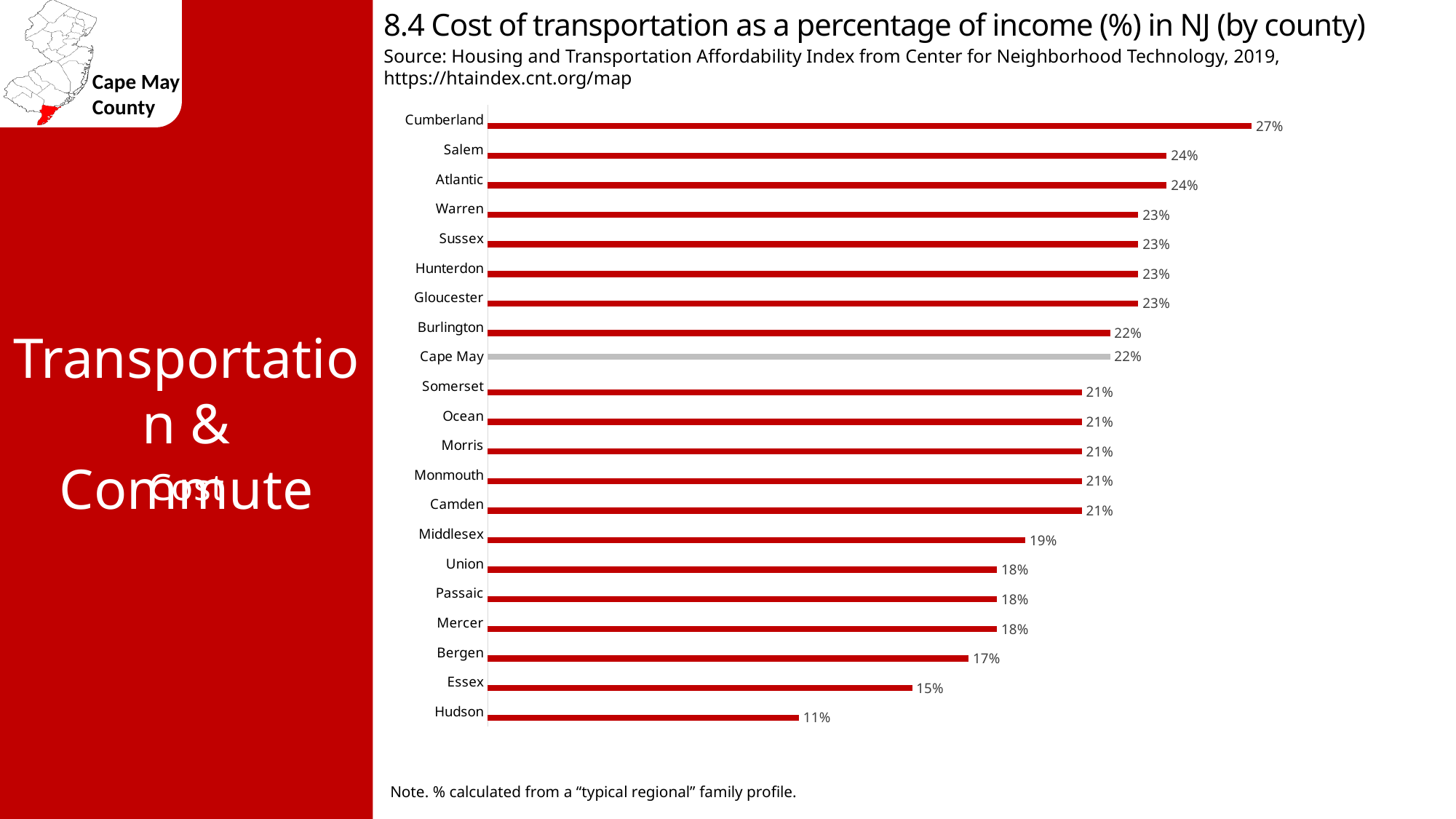
What type of chart is shown on the slide? Bar chart Which county has the highest cost of transportation as a percentage of income? Cumberland What is the value shown for Middlesex County? 19% How many counties are shown in the chart? 21 Which county's bar is shown in grey rather than red? Cape May What is the value shown for Hudson County? 11% Which county has the lowest cost of transportation as a percentage of income? Hudson What is the difference between the values for Cape May and Essex? 7% What is the difference between the values for Cumberland and Hudson? 16% What is the cost of transportation as a percentage of income for Cape May County? 22% What is the value shown for Cumberland County? 27% Which has a higher value, Bergen or Salem? Salem